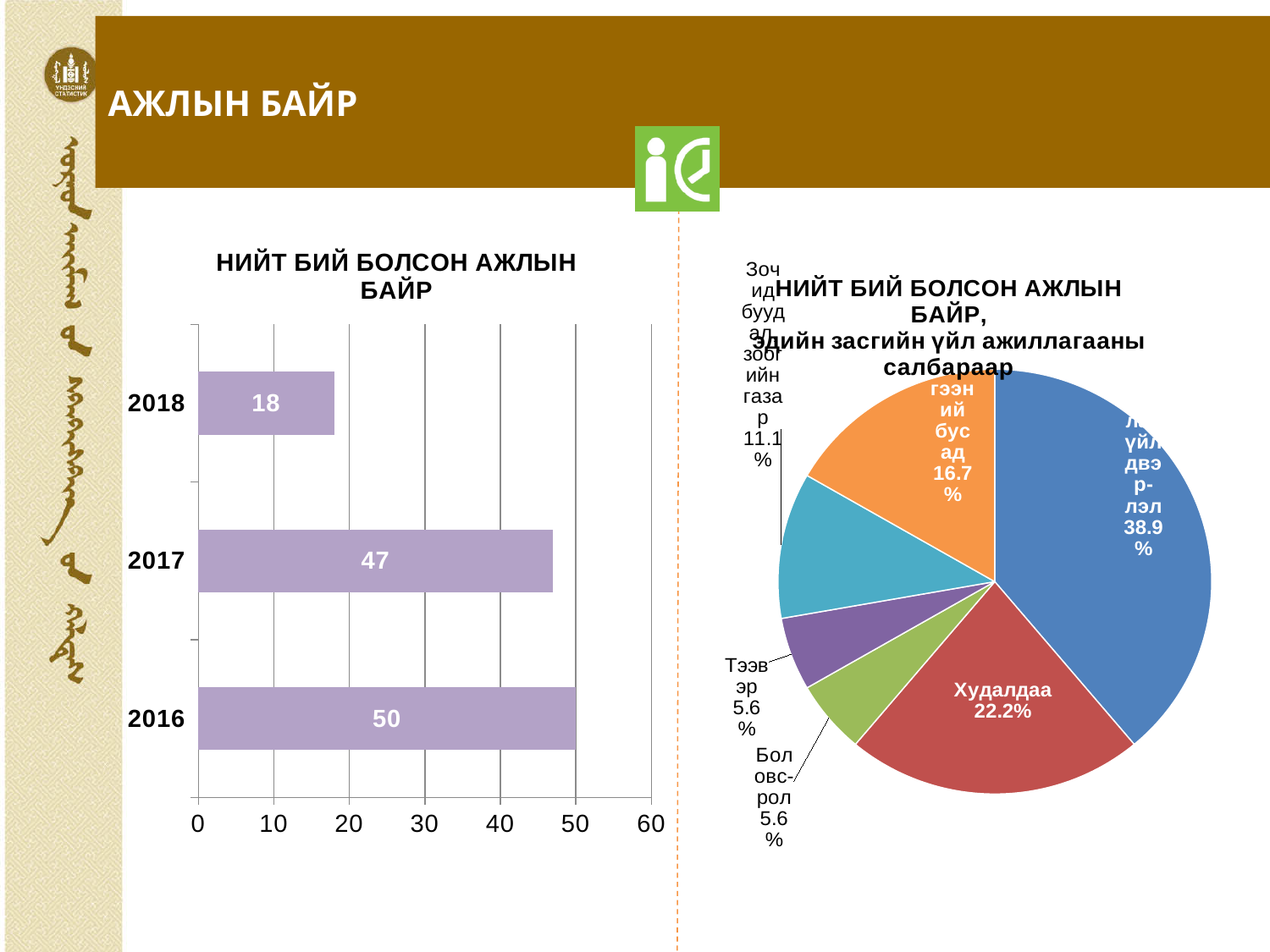
What type of chart is the chart on the left of the slide? bar chart In the bar chart on the left, what is the difference between the values for 2017 and 2018? 29 In the bar chart 'НИЙТ БИЙ БОЛСОН АЖЛЫН БАЙР', what is the value for 2016? 50 In the pie chart on the right, what is the share for Тээвэр? 5.6% In the bar chart 'НИЙТ БИЙ БОЛСОН АЖЛЫН БАЙР', what is the value for 2017? 47 In the bar chart 'НИЙТ БИЙ БОЛСОН АЖЛЫН БАЙР', what is the value for 2018? 18 In the pie chart on the right, what is the share of the largest slice? 38.9% What type of chart is the chart on the right of the slide? pie chart In the bar chart on the left, which year has the lowest value? 2018 In the bar chart on the left, which year has the highest value? 2016 In the bar chart on the left, how many years are shown? 3 In the pie chart on the right, what is the share for Худалдаа? 22.2%